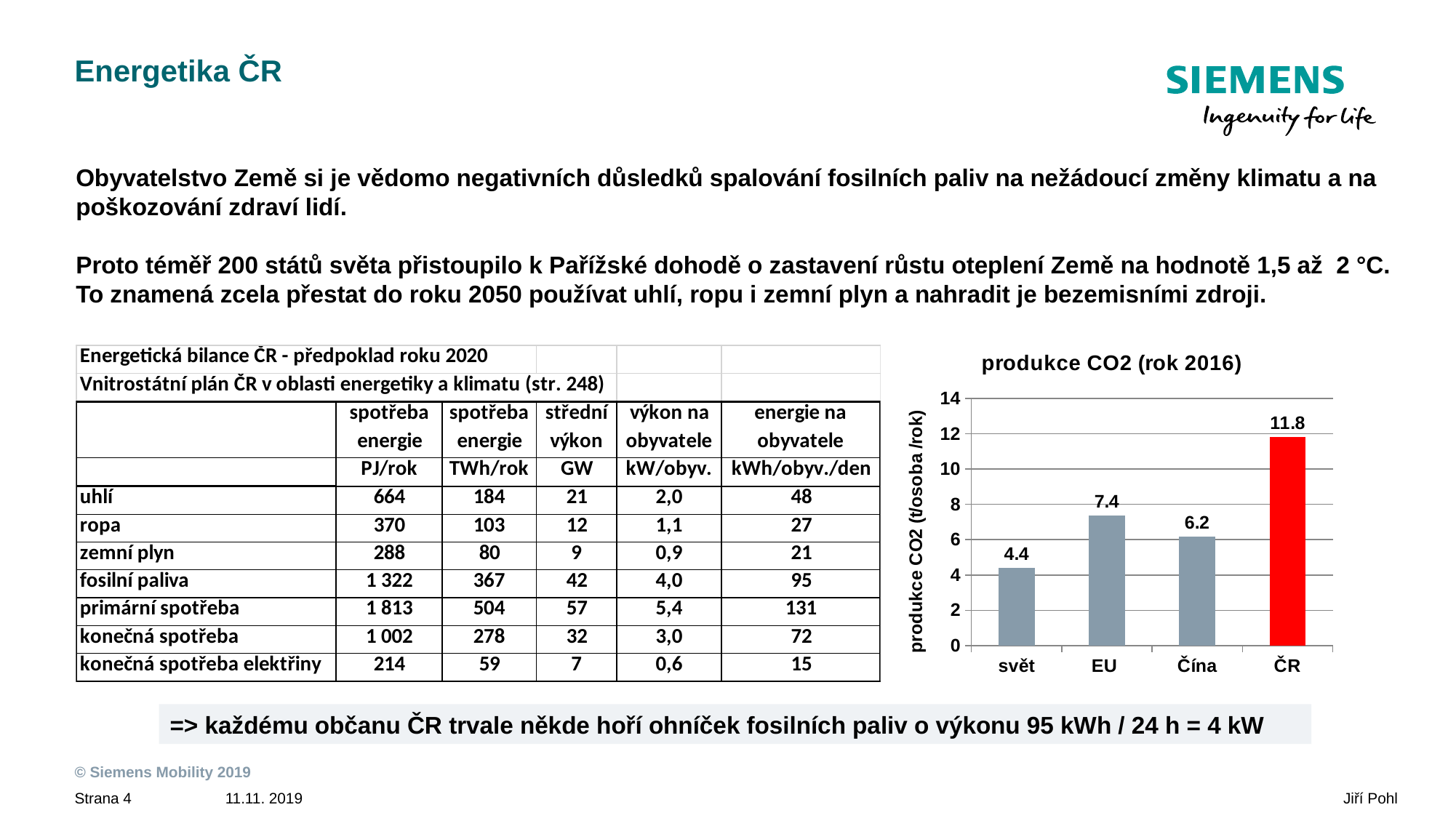
What is the CO2 production value for Čína in the chart? 6.2 What is the CO2 production value for ČR in the chart? 11.8 Which category has the highest CO2 production in the chart? ČR How many categories are shown in the chart? 4 What is the difference between the CO2 production values for ČR and EU? 4.4 Which category has the lowest CO2 production in the chart? svět What kind of chart is shown on the slide? bar chart Which has a higher CO2 production value, EU or Čína? EU What is the title of the chart? produkce CO2 (rok 2016) What is the CO2 production value for EU in the chart? 7.4 What is the CO2 production value for svět in the chart? 4.4 Is the value for ČR greater or less than 10? greater